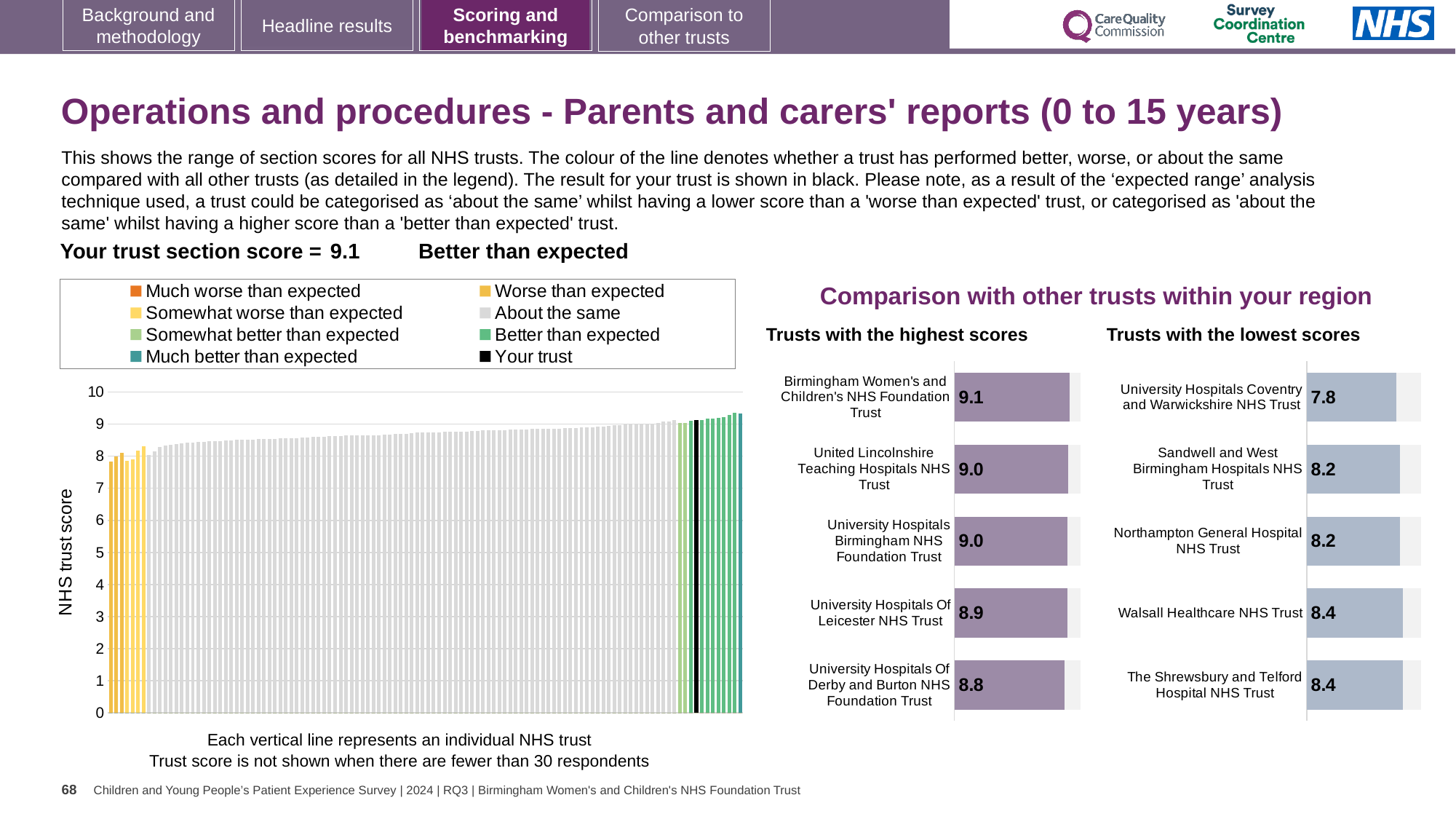
In the 'Trusts with the highest scores' chart, which trust has the lowest score? University Hospitals Of Derby and Burton NHS Foundation Trust How many trusts are shown in the 'Trusts with the lowest scores' chart? 5 In the 'Trusts with the lowest scores' chart, which trust has the lowest score? University Hospitals Coventry and Warwickshire NHS Trust In the large chart on the left showing all NHS trusts, what is the label on the vertical axis? NHS trust score In the 'Trusts with the highest scores' chart, what is the score for University Hospitals Of Leicester NHS Trust? 8.9 In the 'Trusts with the highest scores' chart, what is the score for Birmingham Women's and Children's NHS Foundation Trust? 9.1 In the 'Trusts with the highest scores' chart, what is the difference between the scores of Birmingham Women's and Children's NHS Foundation Trust and University Hospitals Of Derby and Burton NHS Foundation Trust? 0.3 In the 'Trusts with the lowest scores' chart, what is the score for University Hospitals Coventry and Warwickshire NHS Trust? 7.8 How many entries does the legend of the large chart on the left list? 8 In the 'Trusts with the lowest scores' chart, what is the difference between the scores of The Shrewsbury and Telford Hospital NHS Trust and University Hospitals Coventry and Warwickshire NHS Trust? 0.6 In the 'Trusts with the lowest scores' chart, which is larger: the score for Sandwell and West Birmingham Hospitals NHS Trust or Walsall Healthcare NHS Trust? Walsall Healthcare NHS Trust In the large chart on the left, do the trust scores rise or fall from left to right? rise